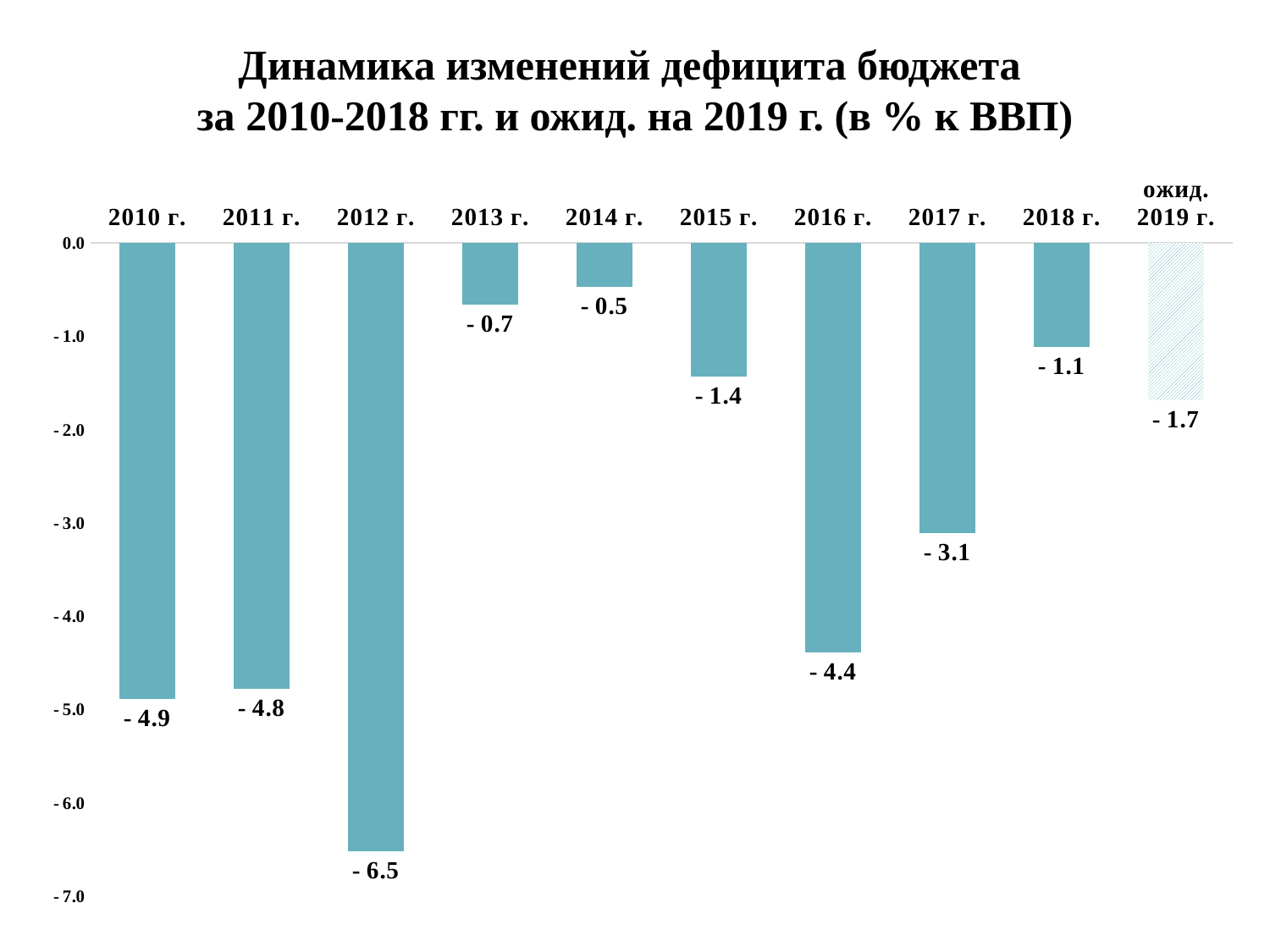
How many years (categories) are shown on the chart? 10 Do the values rise or fall from 2016 г. to 2018 г.? Rise Which year has the highest value (the smallest deficit)? 2014 г. What is the expected value for 2019 г. (ожид. 2019 г.)? - 1.7 What is the difference between the values for 2017 г. and 2018 г.? 2.0 Which bar is drawn with a hatched pattern instead of solid fill? ожид. 2019 г. Which is larger in absolute terms, the deficit for 2010 г. or for 2016 г.? 2010 г. What is the value for 2012 г.? - 6.5 What is the value for 2018 г.? - 1.1 What kind of chart is shown on the slide? Bar chart Which year has the lowest value (the largest deficit)? 2012 г. What is the value for 2016 г.? - 4.4